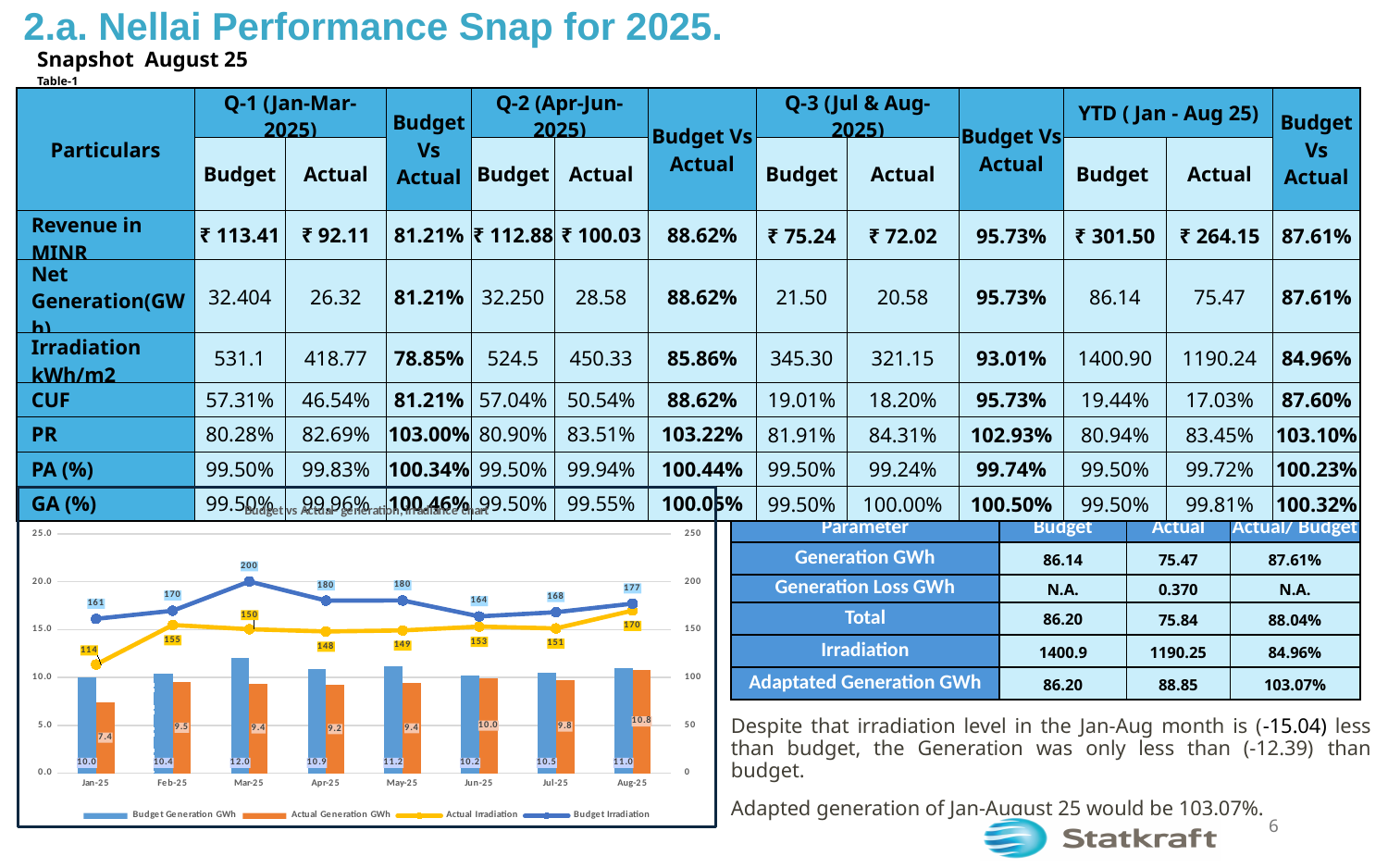
In which month is Actual Irradiation lowest in the chart? Jan-25 Which month has the larger Actual Generation GWh in the chart, Jul-25 or Aug-25? Aug-25 Which series in the chart is drawn as a yellow line? Actual Irradiation What is the Budget Generation GWh value for Mar-25 in the chart? 12.0 In which month is Budget Irradiation highest in the chart? Mar-25 How many series does the chart's legend list? 4 What is the difference between Budget Generation GWh and Actual Generation GWh for Mar-25 in the chart? 2.6 What is the Budget Irradiation value for Aug-25 in the chart? 177 In which month is Actual Generation GWh highest in the chart? Aug-25 What kind of chart is shown at the bottom left of the slide? A combined bar and line chart What is the Actual Generation GWh value for Jan-25 in the chart? 7.4 How many months are plotted along the x axis of the chart? 8